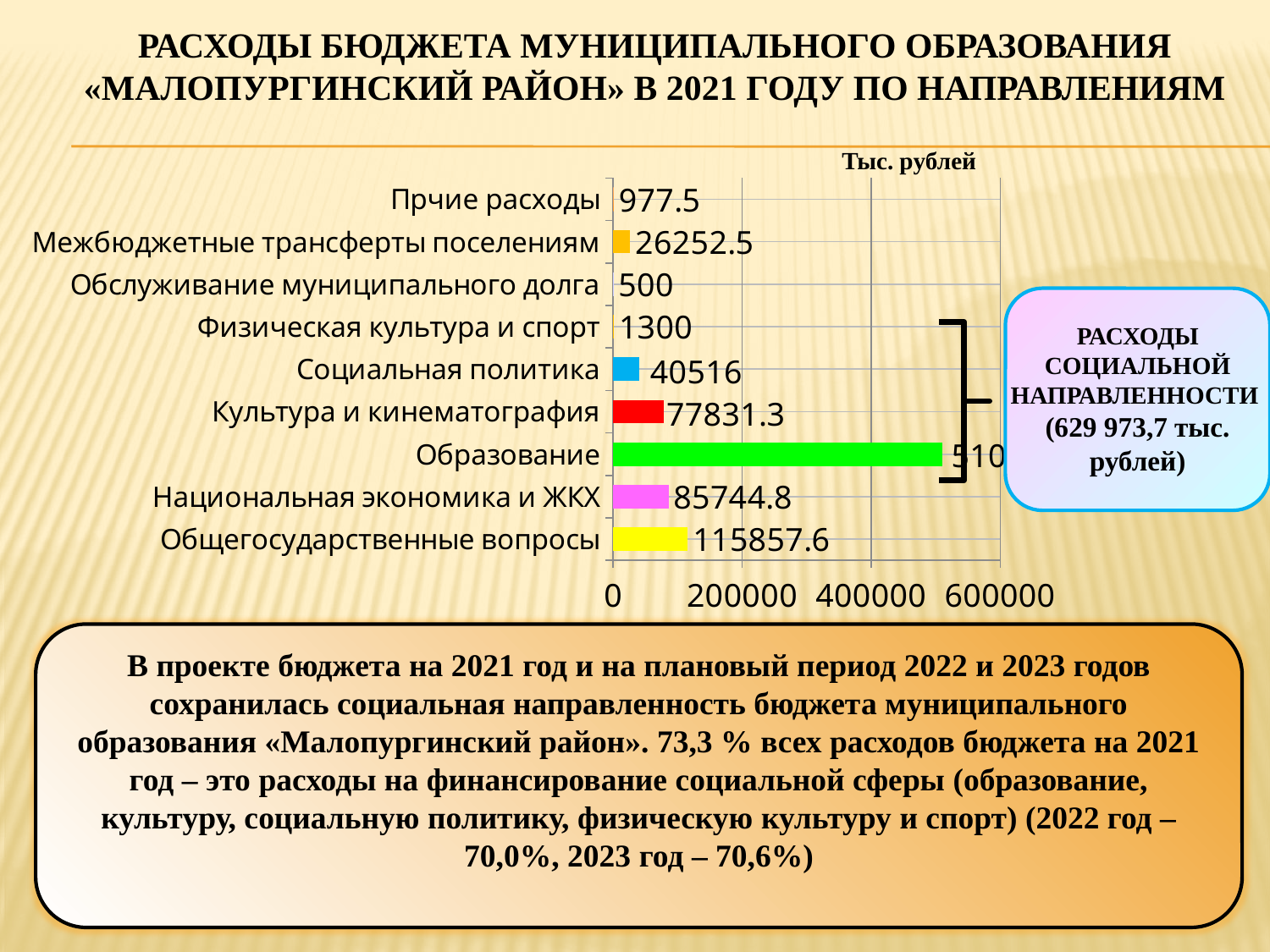
Is the value for Образование greater or less than 400000? greater Which category has the highest value in the chart? Образование What is the value for Общегосударственные вопросы? 115857.6 What is the value for Национальная экономика и ЖКХ? 85744.8 How many expenditure categories are shown in the chart? 9 Which category has the lowest value in the chart? Обслуживание муниципального долга What is the value for Культура и кинематография? 77831.3 In what units are the chart values given, according to the label above the chart? Тыс. рублей What type of chart is shown on the slide? bar chart What is the value for Межбюджетные трансферты поселениям? 26252.5 What is the value for Социальная политика? 40516 What is the difference between Общегосударственные вопросы and Национальная экономика и ЖКХ? 30112.8